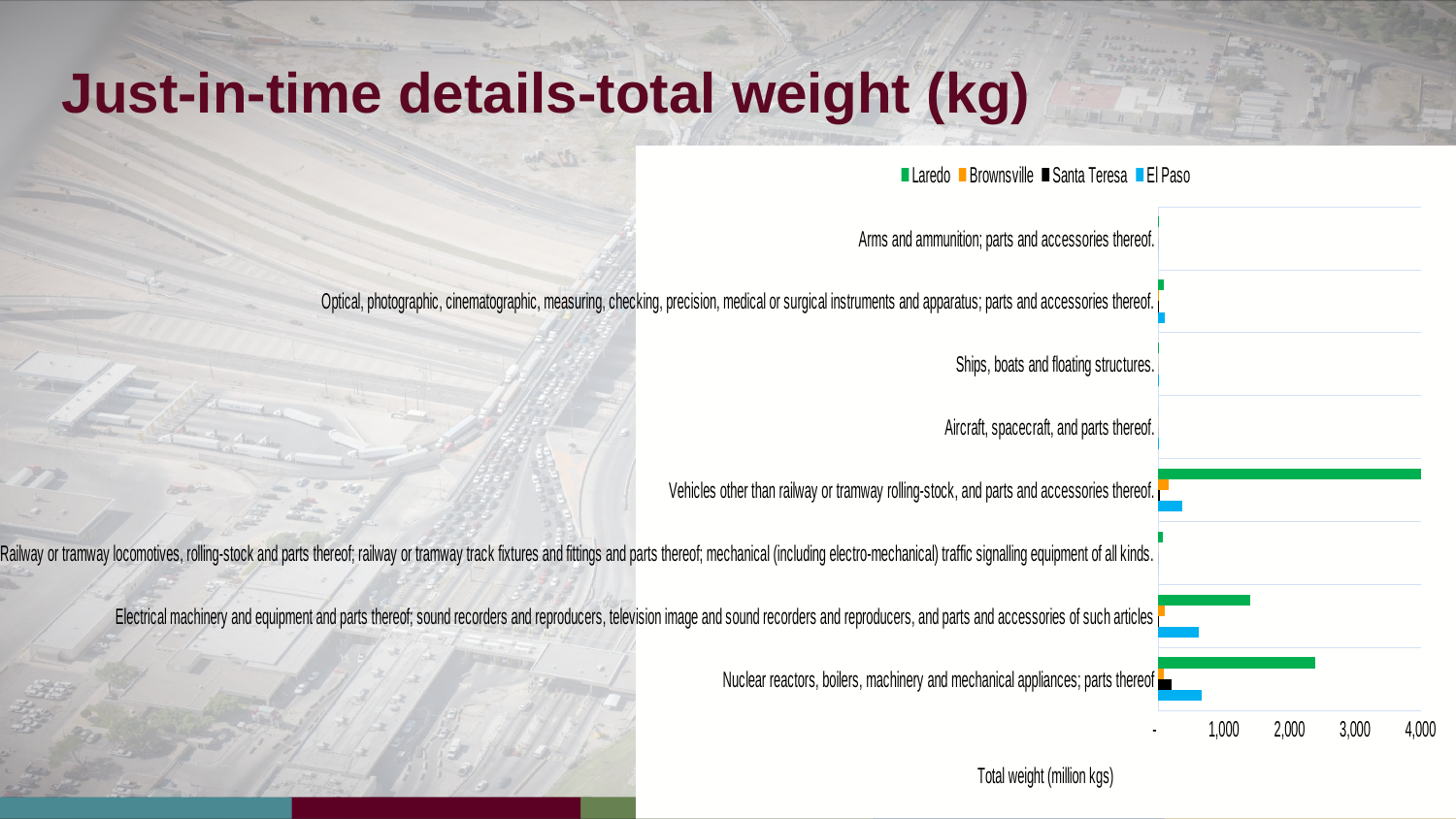
What is the title of the horizontal axis? Total weight (million kgs) Is the Laredo value for Electrical machinery and equipment and parts thereof greater or less than 1,000? greater How many series does the legend list? 4 How many categories are plotted on the chart? 8 Which is larger for Laredo: Nuclear reactors, boilers, machinery and mechanical appliances or Electrical machinery and equipment and parts thereof? Nuclear reactors, boilers, machinery and mechanical appliances Which series is shown in green? Laredo Is the Laredo value for Nuclear reactors, boilers, machinery and mechanical appliances greater or less than 2,000? greater Is the Laredo value for Vehicles other than railway or tramway rolling-stock greater or less than 3,000? greater Which category has the highest Laredo value? Vehicles other than railway or tramway rolling-stock, and parts and accessories thereof. What kind of chart is shown on the slide? bar chart